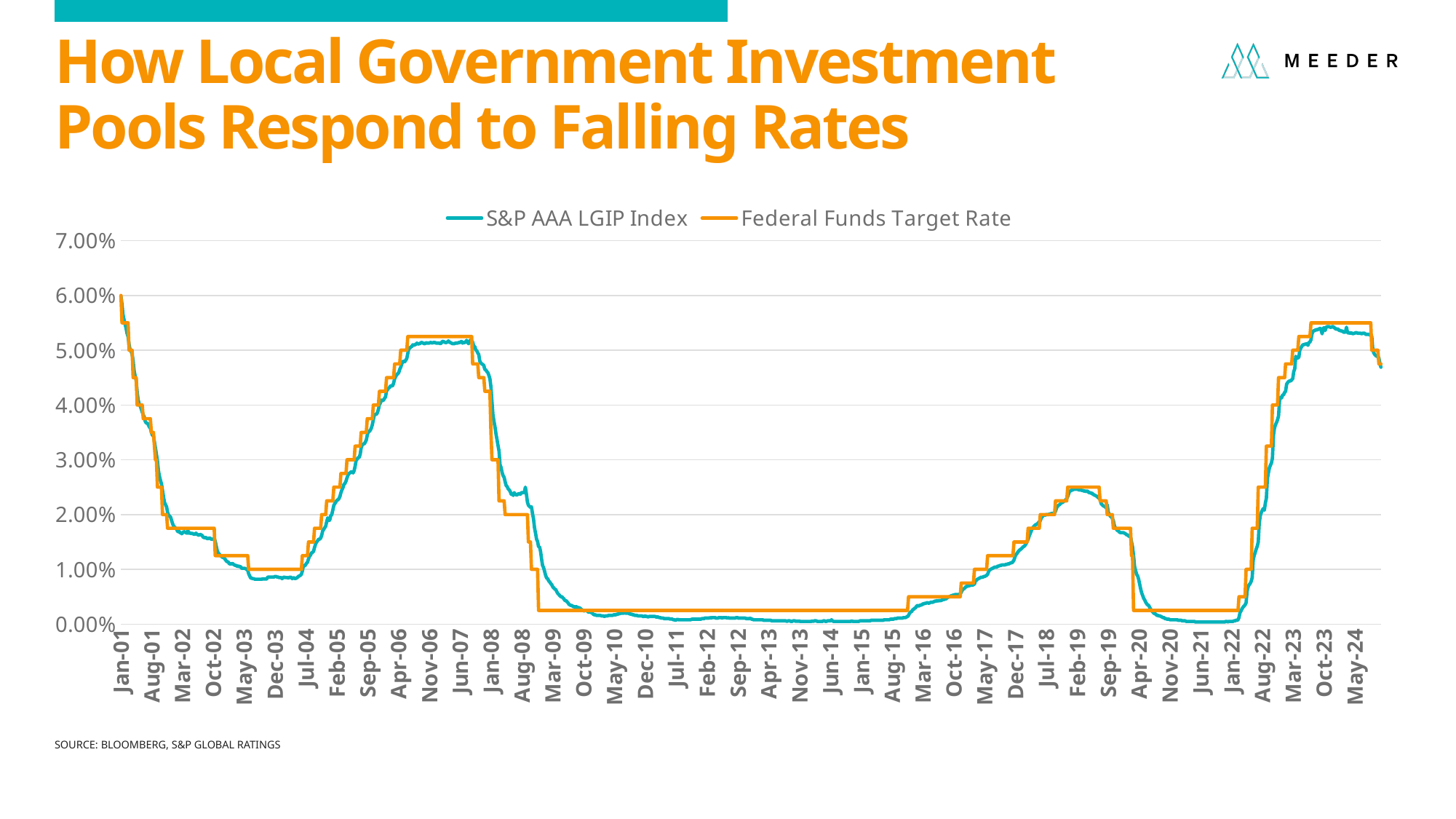
Is the S&P AAA LGIP Index around Jun-21 greater or less than 1.00%? less Which colour is used for the Federal Funds Target Rate line? Orange Does the S&P AAA LGIP Index rise or fall between Jan-08 and Mar-09? Fall Around Aug-08, which series is higher: the S&P AAA LGIP Index or the Federal Funds Target Rate? S&P AAA LGIP Index What kind of chart is shown on the slide? Line chart How many series does the chart legend list? 2 Which series reaches the highest value shown on the chart? Federal Funds Target Rate Is the Federal Funds Target Rate around Jul-11 greater or less than 1.00%? less Is the Federal Funds Target Rate around Nov-06 greater or less than 5.00%? greater Does the S&P AAA LGIP Index rise or fall between Jan-22 and Oct-23? Rise What are the two series named in the chart legend? S&P AAA LGIP Index and Federal Funds Target Rate